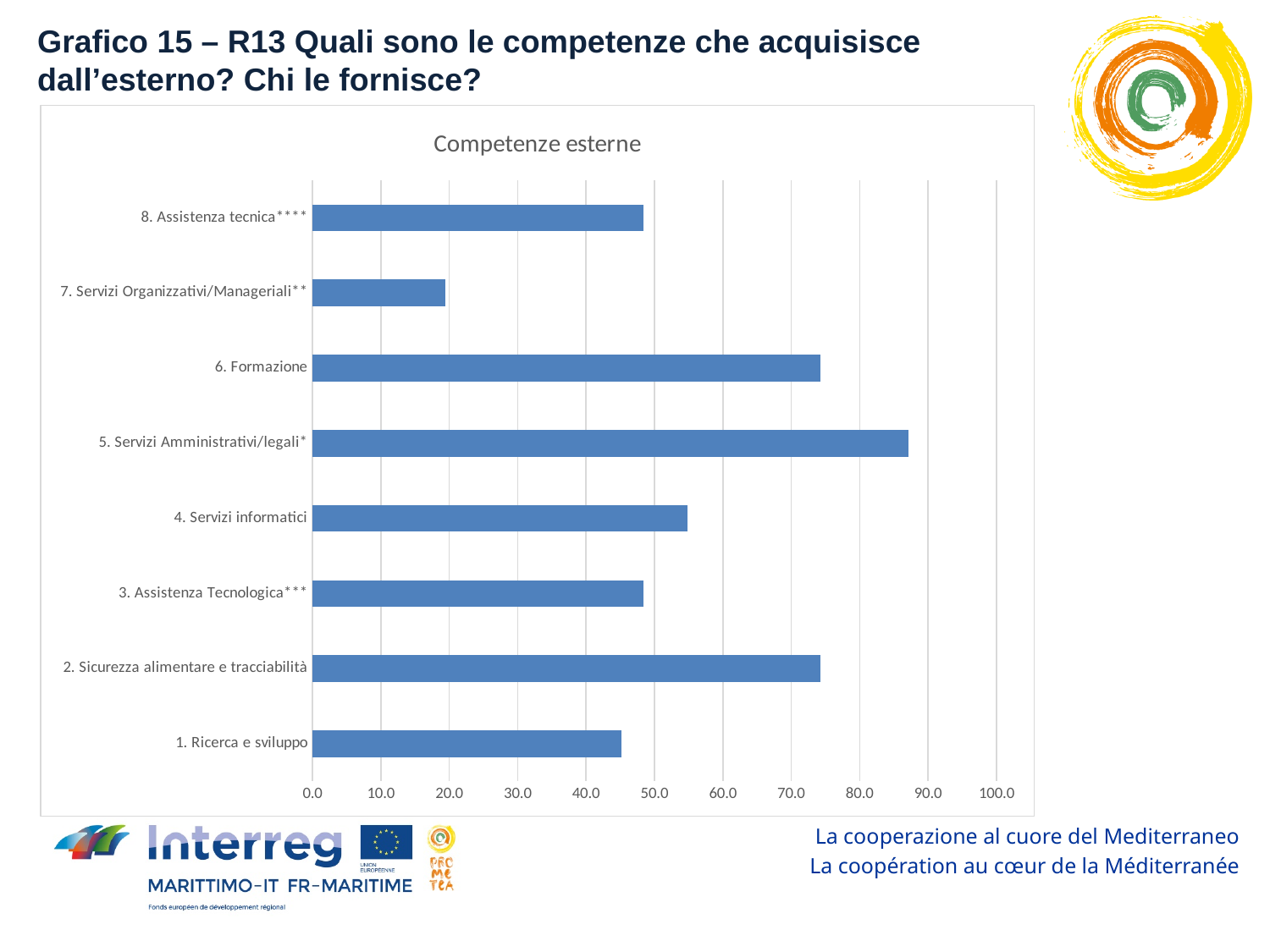
How many categories are plotted in the chart? 8 Is the value for 6. Formazione greater or less than 70.0? greater Is the value for 1. Ricerca e sviluppo greater or less than 50.0? less Which category has the highest value? 5. Servizi Amministrativi/legali* Is the value for 4. Servizi informatici greater or less than 50.0? greater Which is larger, the value for 6. Formazione or the value for 4. Servizi informatici? 6. Formazione Which is larger, the value for 2. Sicurezza alimentare e tracciabilità or the value for 1. Ricerca e sviluppo? 2. Sicurezza alimentare e tracciabilità Which category has the lowest value? 7. Servizi Organizzativi/Manageriali** What is the title of the chart? Competenze esterne What type of chart is shown on the slide? Bar chart